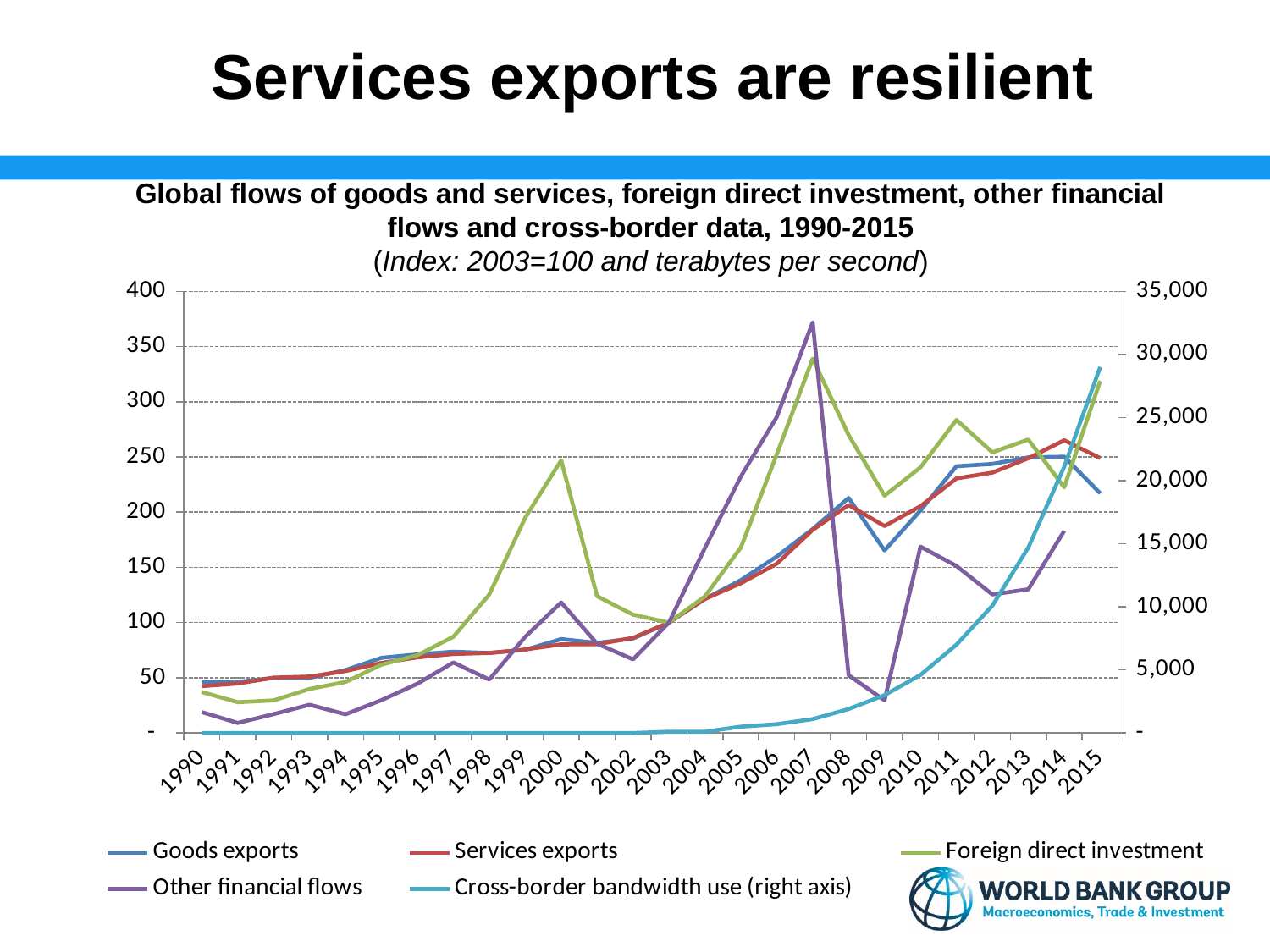
Which series is plotted against the right axis? Cross-border bandwidth use Is the value for Other financial flows in 2007 greater or less than 350? greater Does the Cross-border bandwidth use line generally rise or fall from 1990 to 2015? Rise Is the value for Cross-border bandwidth use in 2015 greater or less than 25,000 on the right axis? greater Is the value for Foreign direct investment in 2000 greater or less than 200? greater In 2009, which is larger: Goods exports or Services exports? Services exports In which year does the Other financial flows line reach its peak? 2007 How many years are plotted along the x axis? 26 How many series does the legend list? 5 In 2015, which is larger: Goods exports or Services exports? Services exports What kind of chart is shown on the slide? Line chart